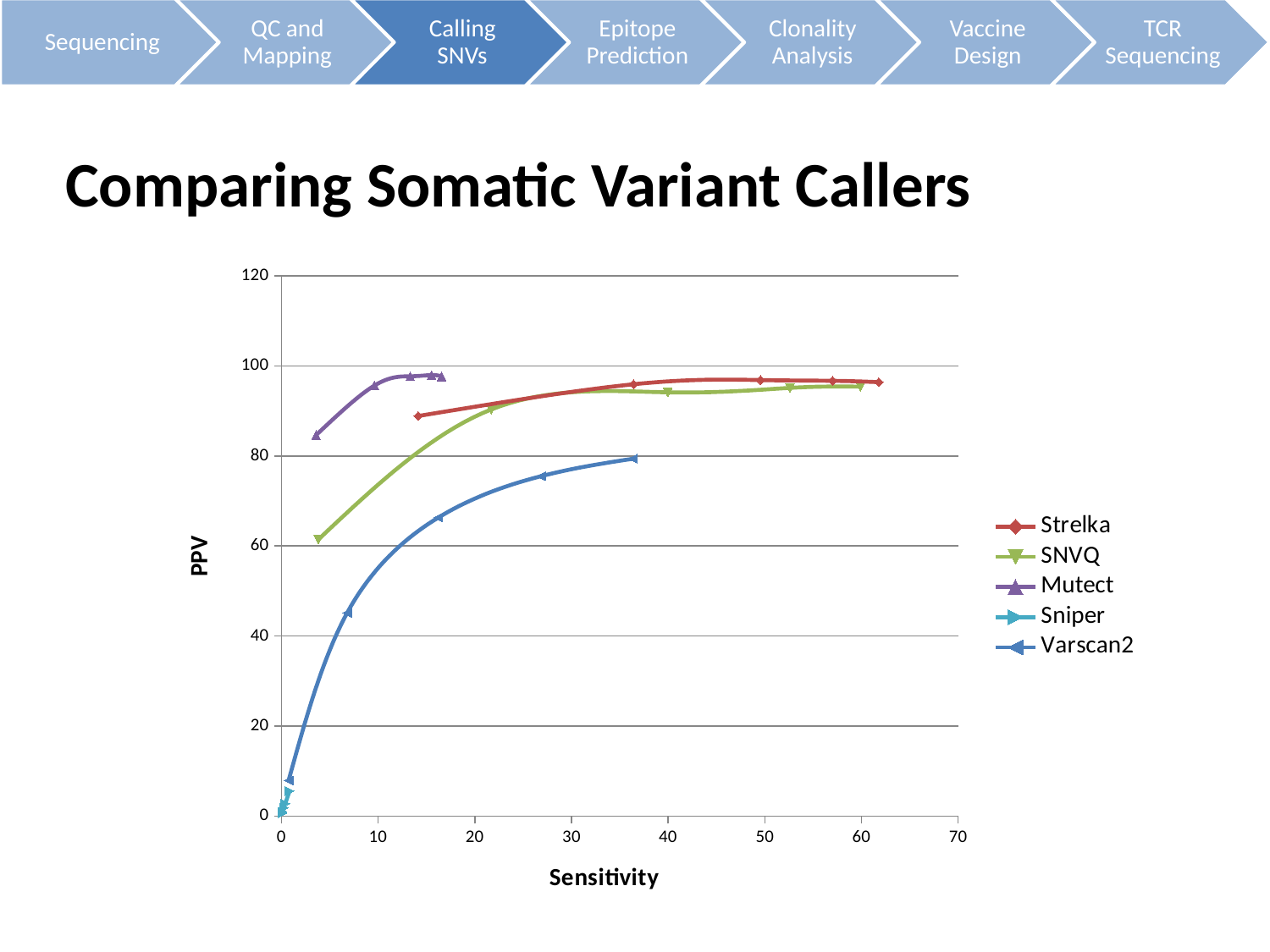
How many series does the legend list? 5 Which series has the lowest PPV values overall? Sniper At a sensitivity of about 15, which series has the higher PPV, Mutect or Strelka? Mutect Is the PPV of Mutect's leftmost point greater or less than 80? greater What kind of chart is shown on the slide? line chart Is the highest PPV value for Varscan2 greater or less than 100? less Is the highest PPV value for Varscan2 greater or less than 60? greater What is the title of the chart on the slide? Comparing Somatic Variant Callers Does the PPV for Varscan2 rise or fall as sensitivity increases? rise Which series reaches the highest sensitivity value on the x axis? Strelka What is the label of the horizontal axis? Sensitivity